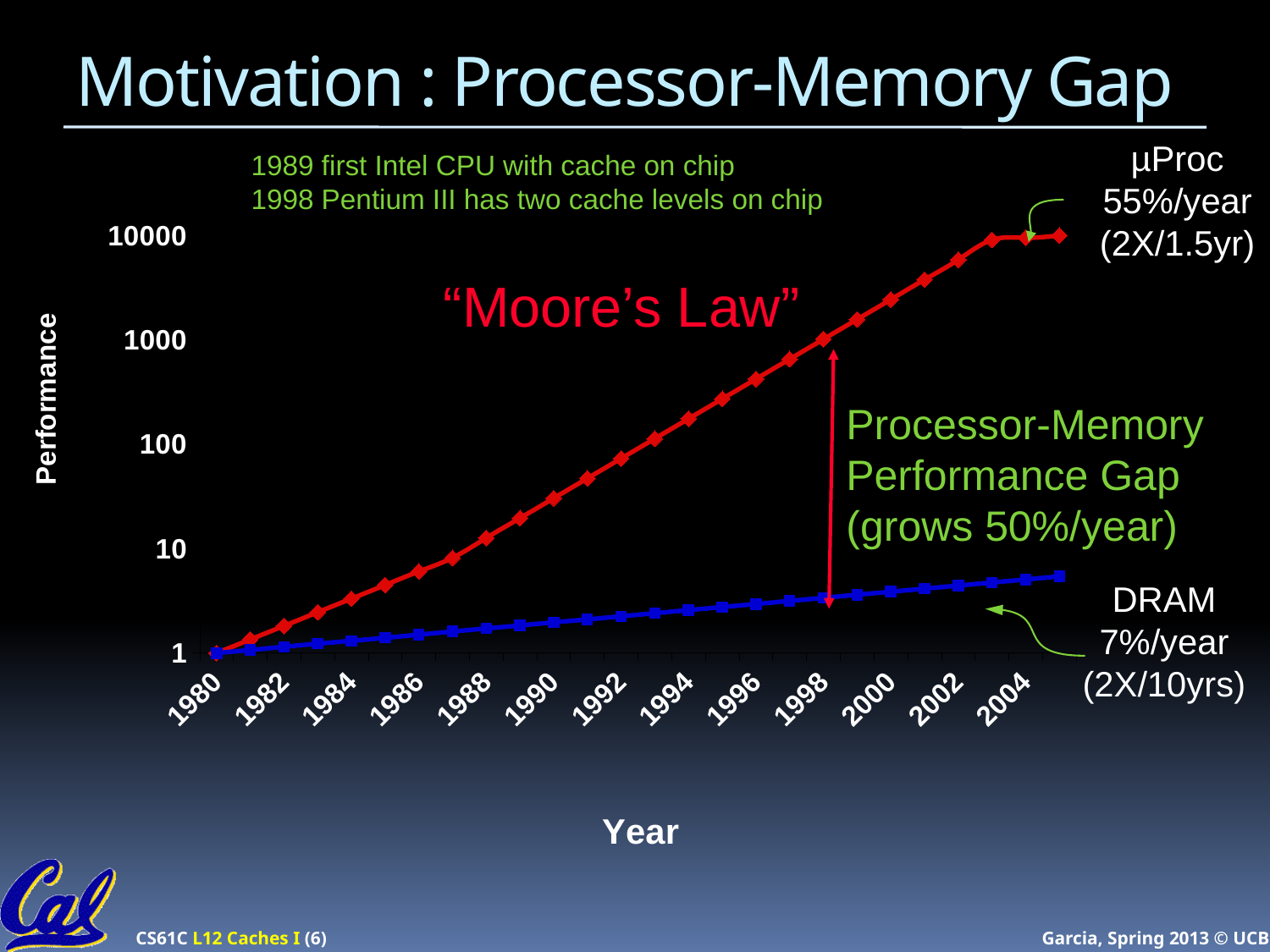
Does the DRAM series rise or fall from 1980 to 2004? rise How many year labels are shown on the x axis? 13 Is the µProc value in 1998 greater or less than 100? greater Is the DRAM value in 2004 greater or less than 10? less Does the µProc series rise or fall from 1980 to 2004? rise Is the µProc value in 1992 greater or less than 10? greater How many data series are plotted on the chart? 2 What kind of chart is shown on the slide? line chart According to the annotation, what is the annual growth rate of the DRAM series? 7%/year Which series is higher in 2004, µProc or DRAM? µProc What is the label of the y axis? Performance